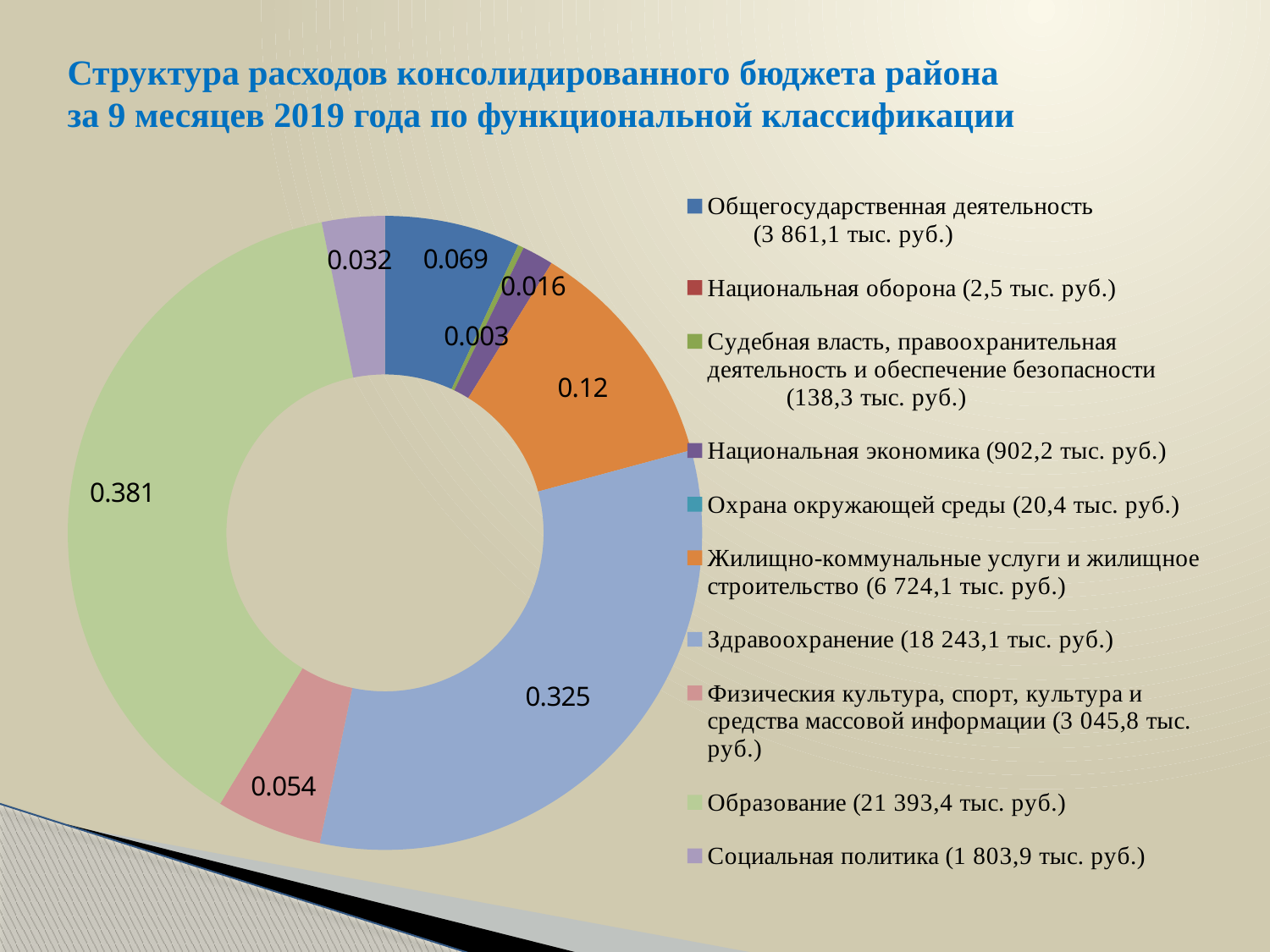
Which is larger: the share for Здравоохранение or the share for Жилищно-коммунальные услуги и жилищное строительство? Здравоохранение What is the difference between the shares for Образование and Здравоохранение? 0.056 What kind of chart is shown on the slide? Doughnut (pie) chart What share of expenditures is shown for Образование? 0.381 What share of expenditures is shown for Общегосударственная деятельность? 0.069 According to the legend, what amount in thousand rubles is given for Образование? 21 393,4 тыс. руб. What is the share shown for Физическия культура, спорт, культура и средства массовой информации? 0.054 What share of expenditures is shown for Жилищно-коммунальные услуги и жилищное строительство? 0.12 Which category has the largest share of expenditures? Образование How many categories does the legend list? 10 What share of expenditures is shown for Здравоохранение? 0.325 What share of expenditures is shown for Социальная политика? 0.032